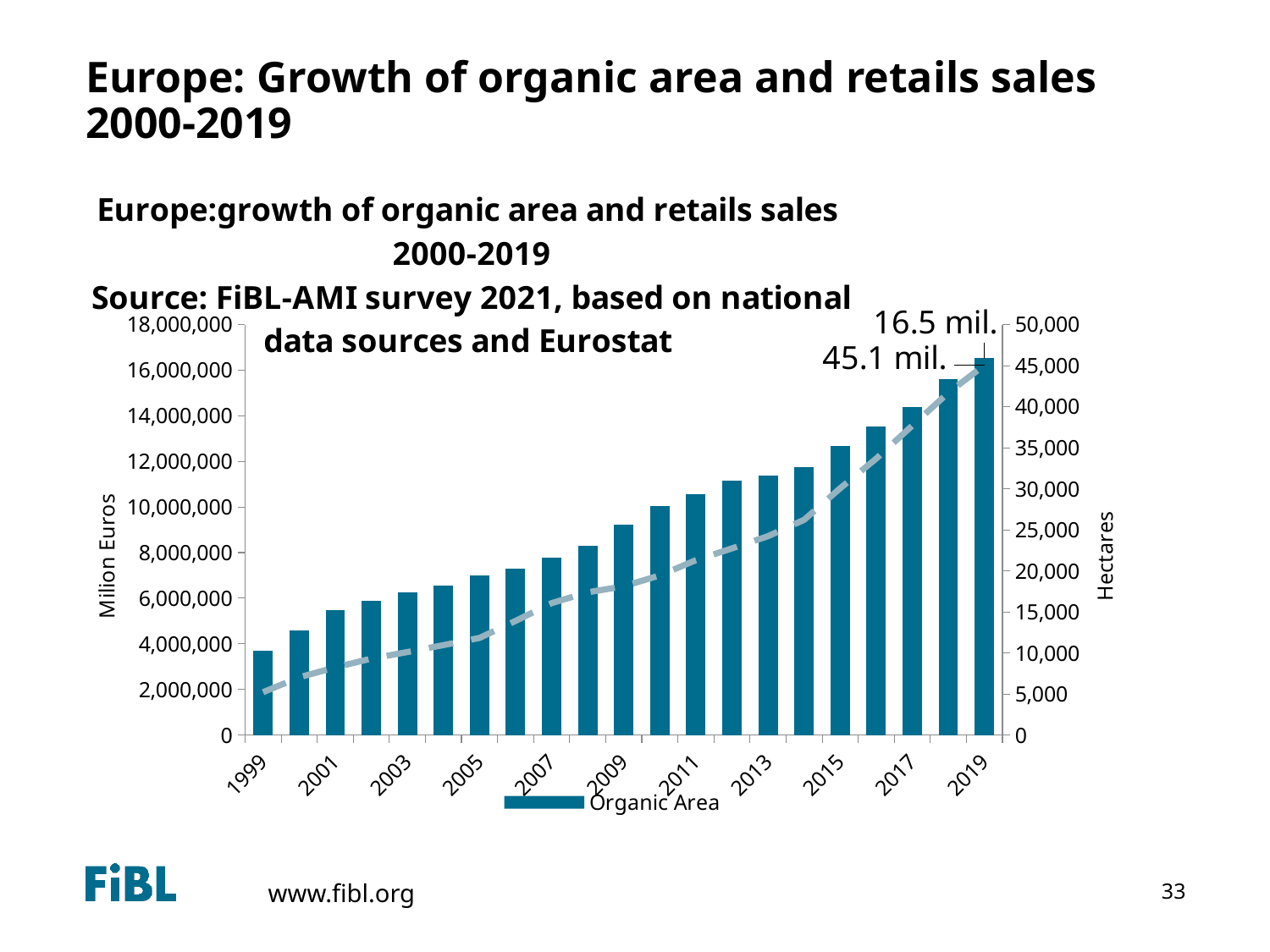
Is the bar value for 1999 greater or less than 4,000,000? less Which bar is taller, 2013 or 2007? 2013 What value is annotated at the end of the dashed line in 2019? 45.1 mil. Which year has the shortest bar? 1999 What is the label of the left vertical axis? Milion Euros Is the bar value for 2009 greater or less than 8,000,000? greater Which year has the tallest bar? 2019 What value is annotated at the top of the 2019 bar? 16.5 mil. Do the bar values rise or fall from 1999 to 2019? rise How many bars are plotted in the chart? 21 What kind of chart is shown on the slide? bar chart with a dashed line How many series does the legend list? 1